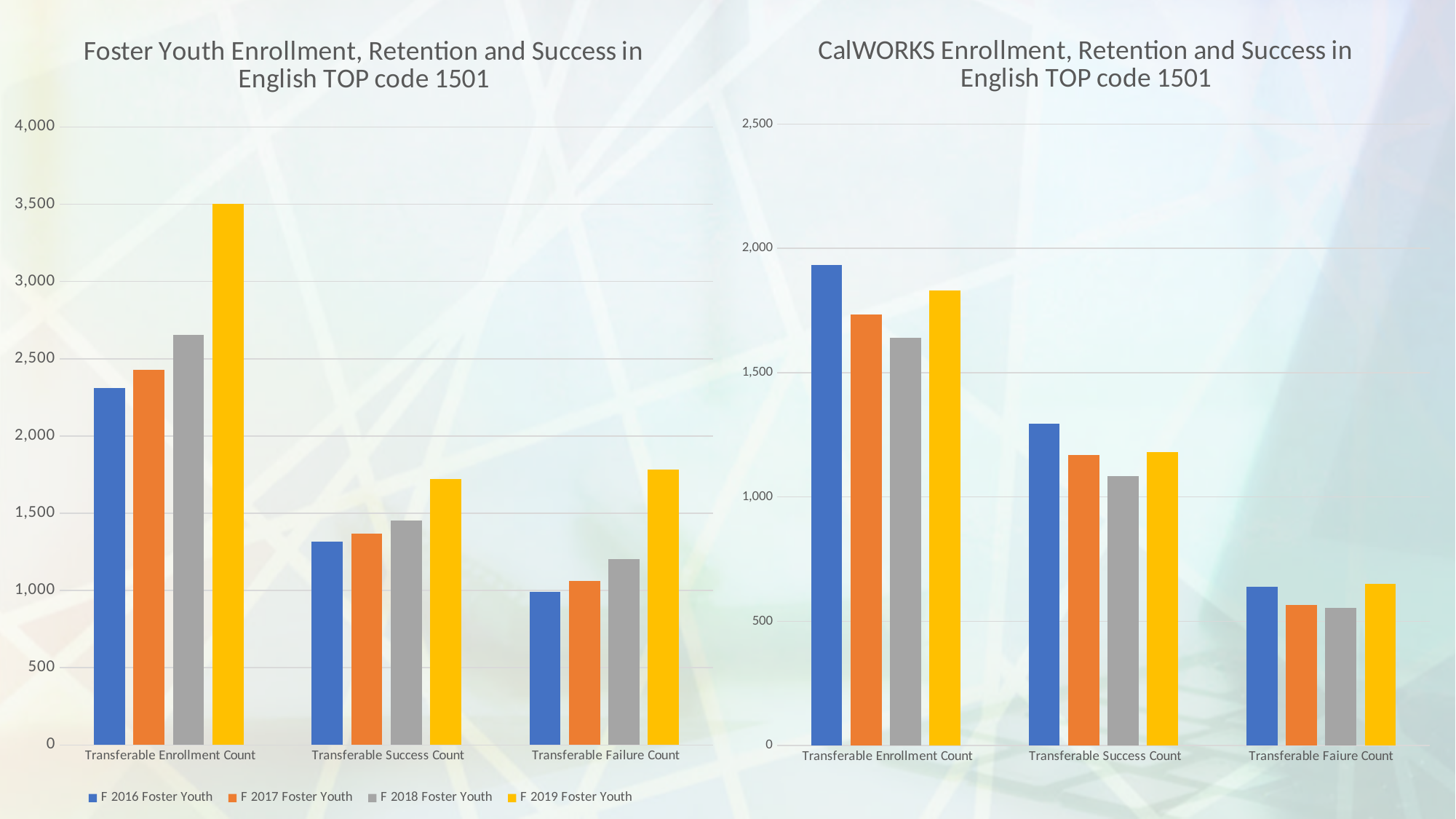
How many categories are shown on the x axis of the 'Foster Youth Enrollment, Retention and Success in English TOP code 1501' chart? 3 How many series does the legend of the 'Foster Youth Enrollment, Retention and Success in English TOP code 1501' chart list? 4 In the 'CalWORKS Enrollment, Retention and Success in English TOP code 1501' chart, is the tallest Transferable Enrollment Count bar greater or less than 1,500? greater In the 'Foster Youth Enrollment, Retention and Success in English TOP code 1501' chart, which is larger for F 2018 Foster Youth: Transferable Success Count or Transferable Failure Count? Transferable Success Count In the 'Foster Youth Enrollment, Retention and Success in English TOP code 1501' chart, which series has the highest Transferable Enrollment Count? F 2019 Foster Youth In the 'Foster Youth Enrollment, Retention and Success in English TOP code 1501' chart, is the Transferable Enrollment Count for F 2019 Foster Youth greater or less than 3,000? greater In the 'CalWORKS Enrollment, Retention and Success in English TOP code 1501' chart, is the highest Transferable Faiure Count bar greater or less than 1,000? less What is the title of the chart on the right side of the slide? CalWORKS Enrollment, Retention and Success in English TOP code 1501 In the 'CalWORKS Enrollment, Retention and Success in English TOP code 1501' chart, which category contains the tallest bar? Transferable Enrollment Count In the 'Foster Youth Enrollment, Retention and Success in English TOP code 1501' chart, do the Transferable Enrollment Count values rise or fall from F 2016 to F 2019? rise What kind of chart is the 'Foster Youth Enrollment, Retention and Success in English TOP code 1501' chart? bar chart